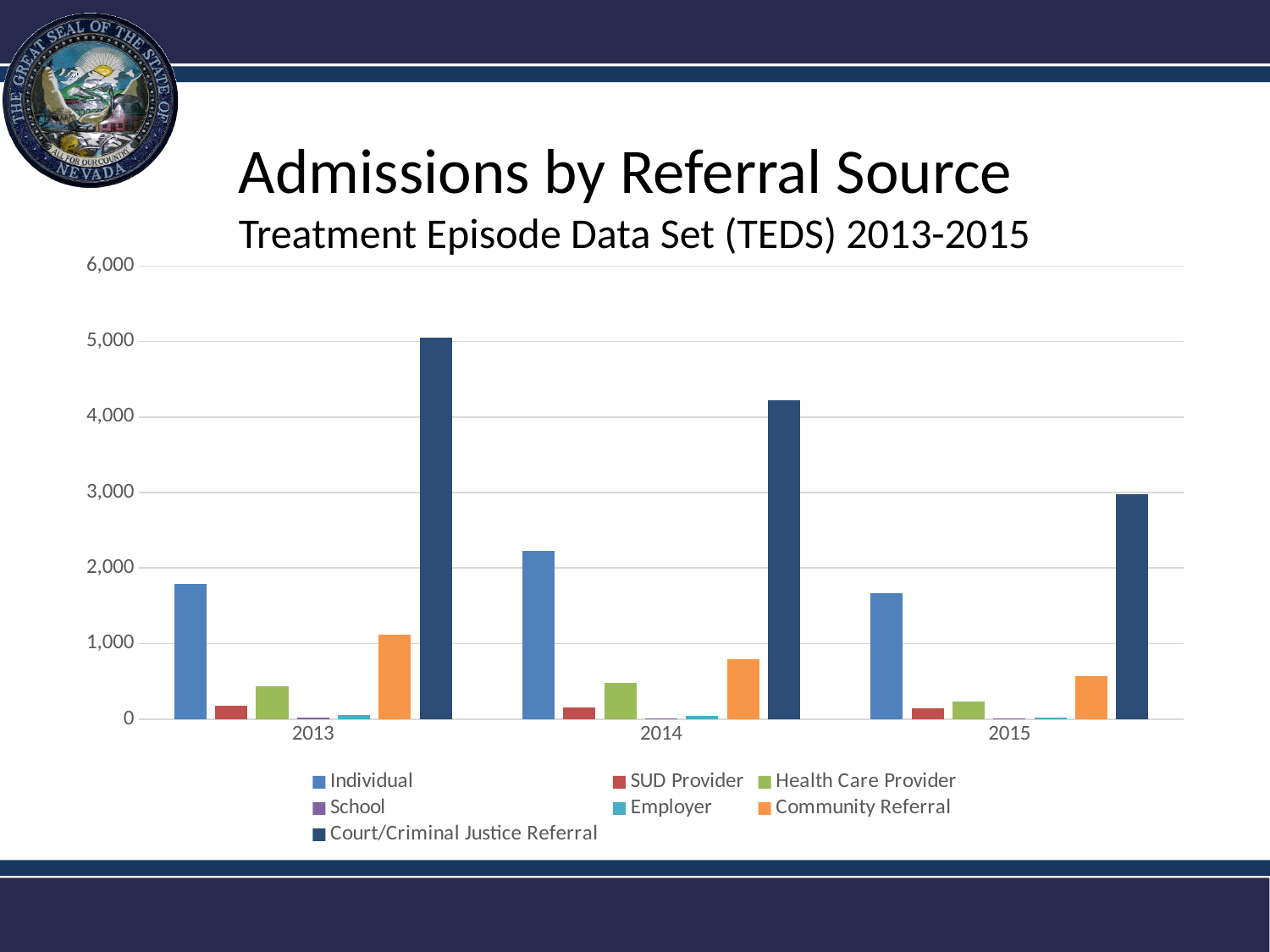
Is the value for Individual in 2014 greater or less than 2,000? greater Is the value for Community Referral in 2013 greater or less than 1,000? greater Which is larger, the Individual admissions in 2013 or in 2014? 2014 Do the Court/Criminal Justice Referral admissions rise or fall from 2013 to 2015? Fall How many years are shown on the x axis? 3 Which referral source has the highest admissions in 2015? Court/Criminal Justice Referral What kind of chart is shown on the slide? Bar chart Which is larger, the Community Referral admissions in 2013 or in 2015? 2013 Is the value for Court/Criminal Justice Referral in 2013 greater or less than 4,000? greater What is the title of the chart? Admissions by Referral Source How many series does the legend list? 7 Which referral source has the highest admissions in 2013? Court/Criminal Justice Referral